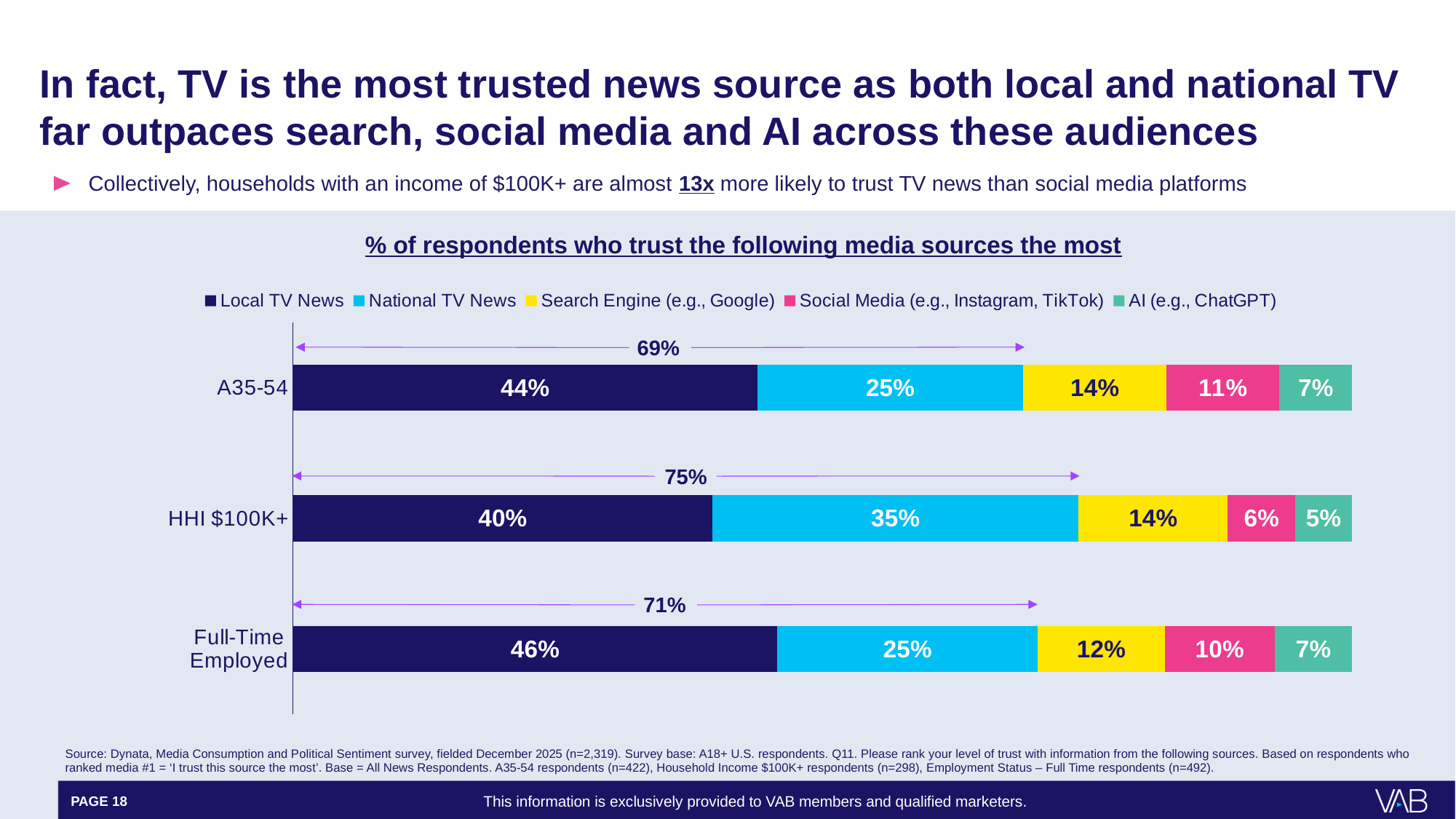
What is the title of the chart? % of respondents who trust the following media sources the most How many series does the legend list? 5 Which audience has the lowest share trusting Social Media the most? HHI $100K+ What percentage of HHI $100K+ respondents trust National TV News the most? 35% What percentage of A35-54 respondents trust Local TV News the most? 44% Which audience has the highest share trusting Local TV News the most? Full-Time Employed Is the Search Engine share larger for A35-54 or for Full-Time Employed? A35-54 What kind of chart is shown on the slide? Stacked bar chart How many audience categories are shown on the chart? 3 What percentage of Full-Time Employed respondents trust Social Media the most? 10% What is the difference between the Local TV News and National TV News shares for A35-54? 19 percentage points What is the combined Local TV News and National TV News share for HHI $100K+, as labelled by the arrow? 75%